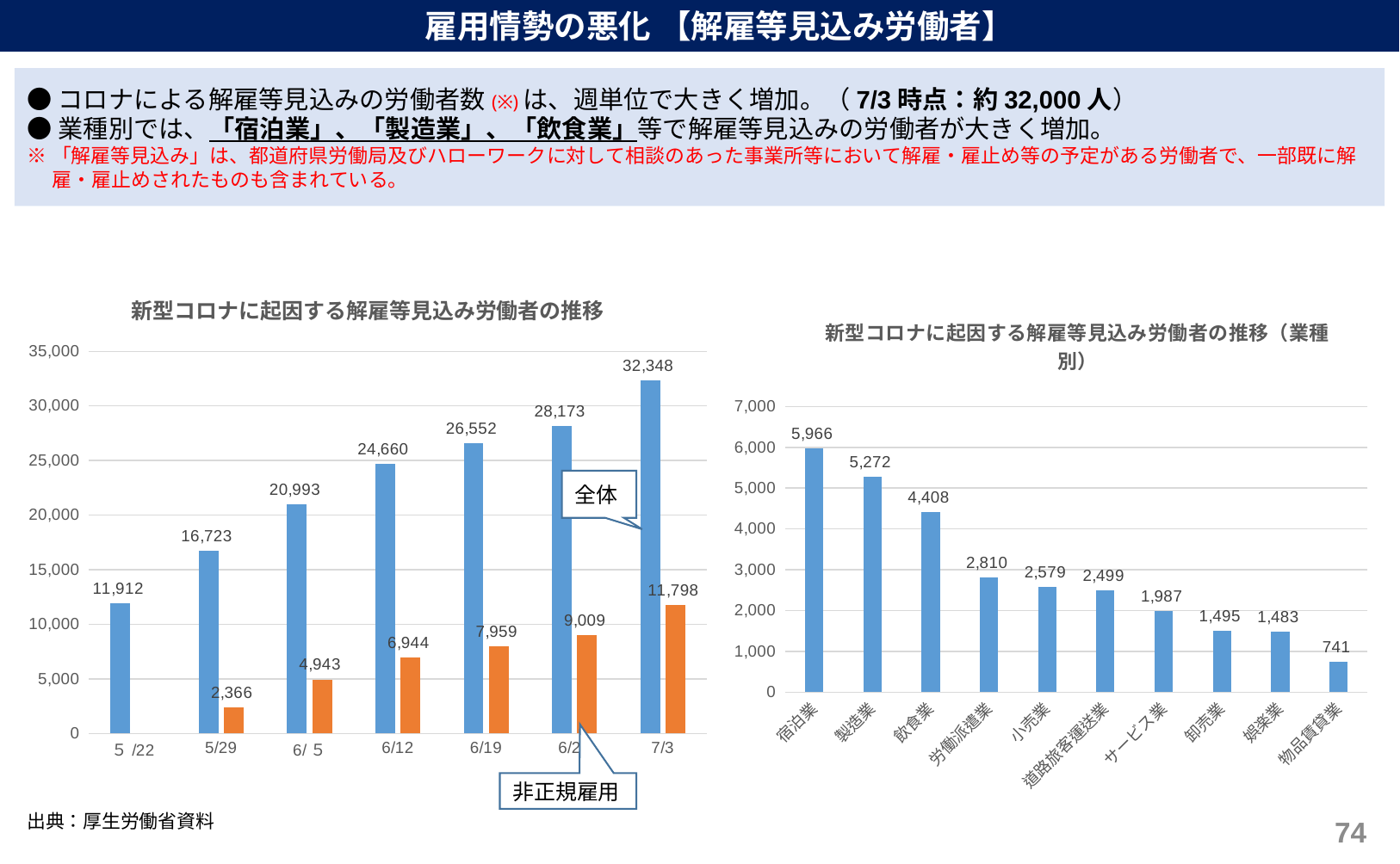
In the right chart (業種別), which industry has the highest value? 宿泊業 In the left chart (新型コロナに起因する解雇等見込み労働者の推移), how many dates are shown on the x axis? 7 What type of chart is the right chart (業種別)? bar chart In the right chart (業種別), what is the value for 飲食業? 4,408 In the right chart (業種別), which industry has the lowest value? 物品賃貸業 In the left chart (新型コロナに起因する解雇等見込み労働者の推移), what is the 非正規雇用 value for 6/12? 6,944 In the right chart (業種別), what is the difference between 宿泊業 and 製造業? 694 In the left chart (新型コロナに起因する解雇等見込み労働者の推移), what are the two series labelled in the callouts? 全体 and 非正規雇用 In the left chart (新型コロナに起因する解雇等見込み労働者の推移), do the 全体 values rise or fall from 5/22 to 7/3? rise In the right chart (業種別), how many industries are shown? 10 In the left chart (新型コロナに起因する解雇等見込み労働者の推移), what is the 全体 value for 7/3? 32,348 In the left chart (新型コロナに起因する解雇等見込み労働者の推移), what is the difference between the 全体 value and the 非正規雇用 value on 7/3? 20,550